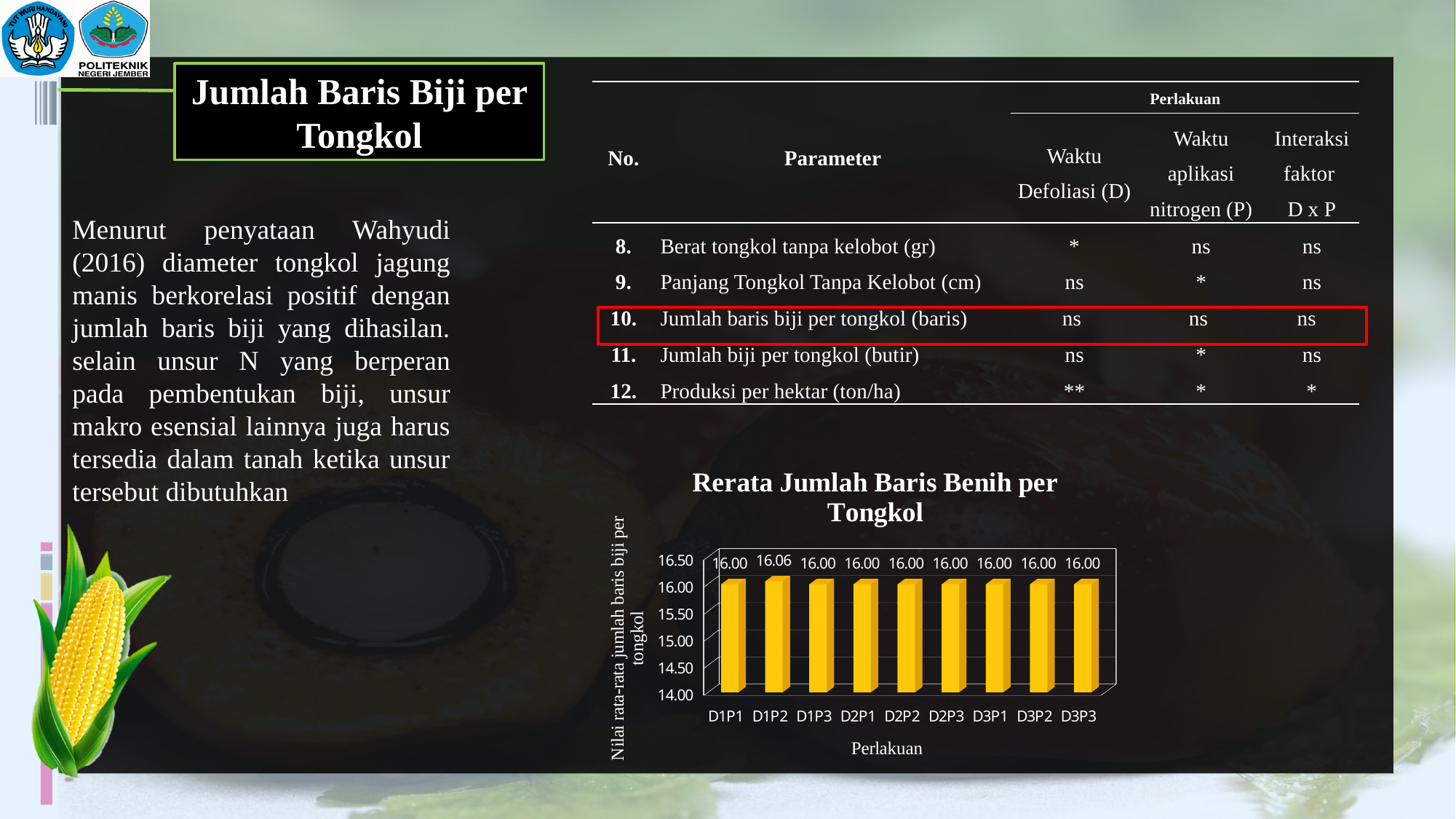
Which treatment has the highest value in the chart? D1P2 What is the value for D3P3 in the chart? 16.00 Is the value for D2P2 greater or less than 15.00? greater What is the difference between the values for D1P2 and D1P1? 0.06 Which is larger, the value for D1P2 or the value for D3P1? D1P2 What is the value for D2P1 in the chart? 16.00 What kind of chart is shown on the slide? bar chart What is the label of the x axis of the chart? Perlakuan What is the value for D1P2 in the chart? 16.06 What is the title of the chart? Rerata Jumlah Baris Benih per Tongkol How many treatments are shown on the x axis of the chart? 9